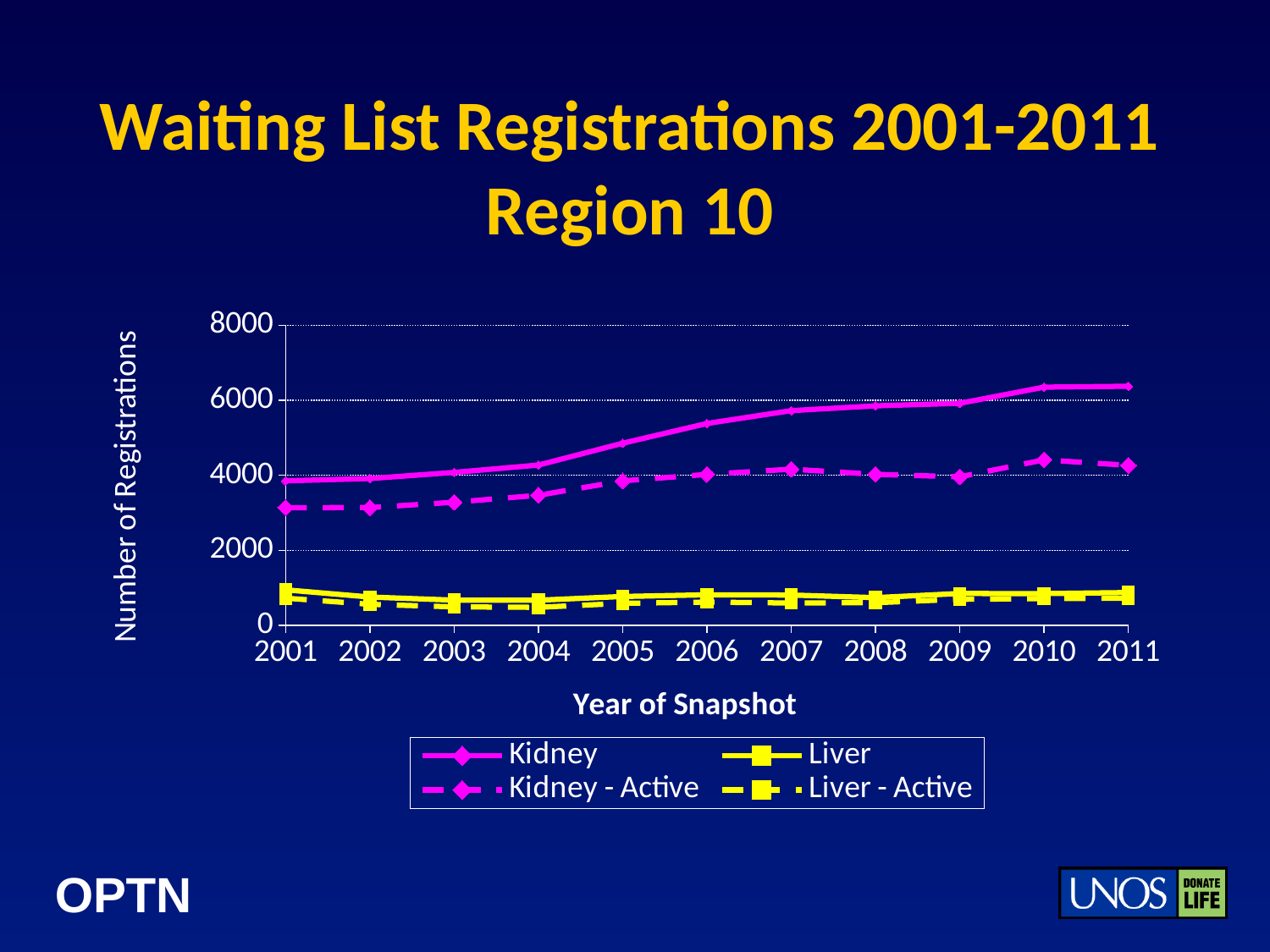
Is the Liver value for 2005 greater or less than 2000? less Does the Kidney series generally rise or fall from 2001 to 2011? rise Is the Kidney value for 2011 greater or less than 6000? greater How many series does the legend list? 4 Is the Kidney value for 2001 greater or less than 4000? less Which series has the larger value in 2011, Kidney or Liver? Kidney How many years are shown along the x axis? 11 What kind of chart is shown on the slide? line chart What is the label on the x axis? Year of Snapshot What is the label on the y axis? Number of Registrations